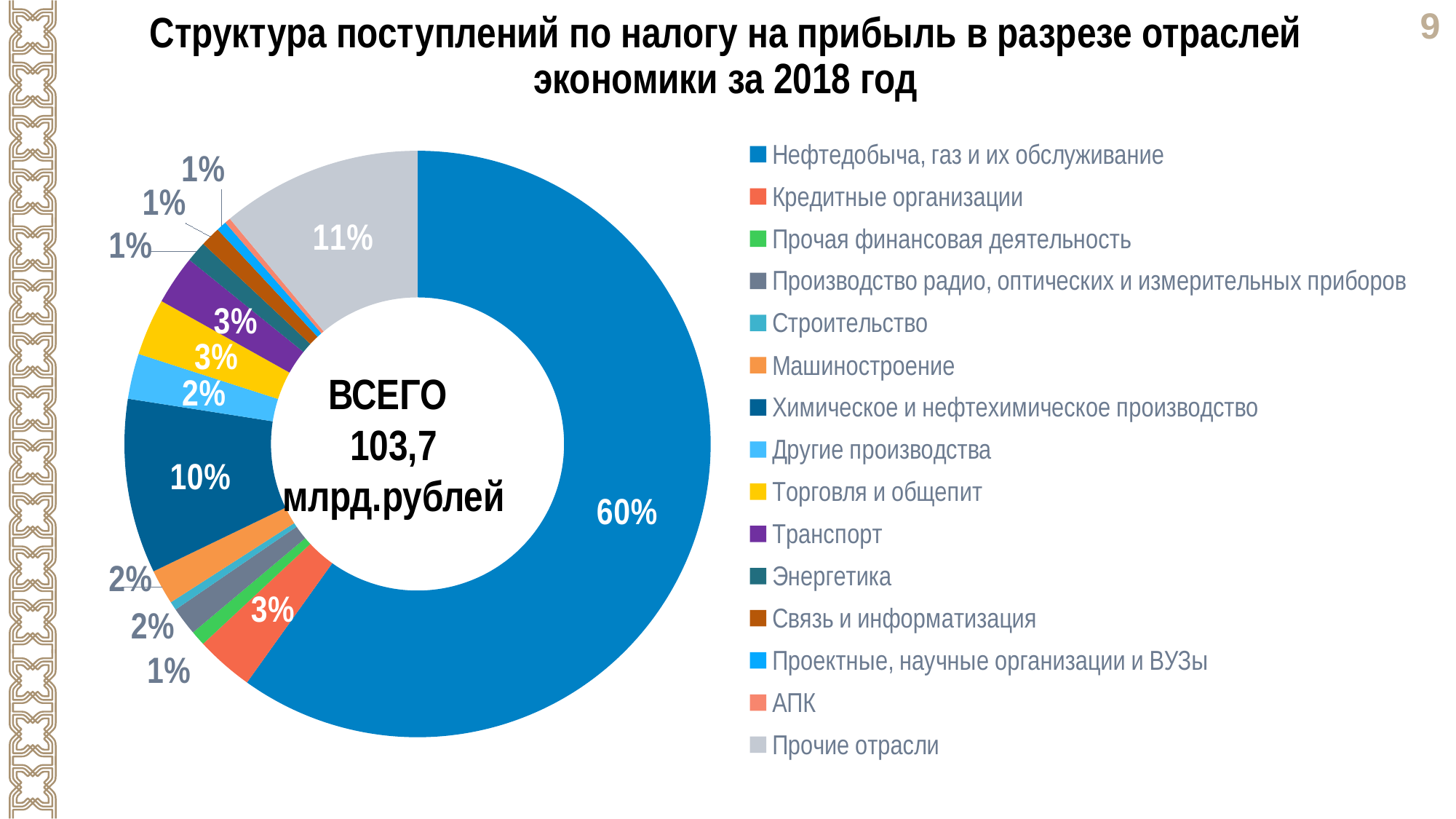
What is the difference in percentage points between the share of Нефтедобыча, газ и их обслуживание and the share of Прочие отрасли? 49% What kind of chart is shown on the slide? Pie (doughnut) chart What total amount is shown in the centre of the chart? 103,7 млрд.рублей Which has the larger share: Кредитные организации or Другие производства? Кредитные организации Which has the larger share: Химическое и нефтехимическое производство or Прочие отрасли? Прочие отрасли What share of profit tax receipts comes from Нефтедобыча, газ и их обслуживание? 60% What share is shown for Химическое и нефтехимическое производство? 10% What share is shown for Кредитные организации? 3% Which sector has the largest share of profit tax receipts? Нефтедобыча, газ и их обслуживание What share is shown for Торговля и общепит? 3% What share is shown for Прочие отрасли? 11% How many sectors are listed in the legend? 15